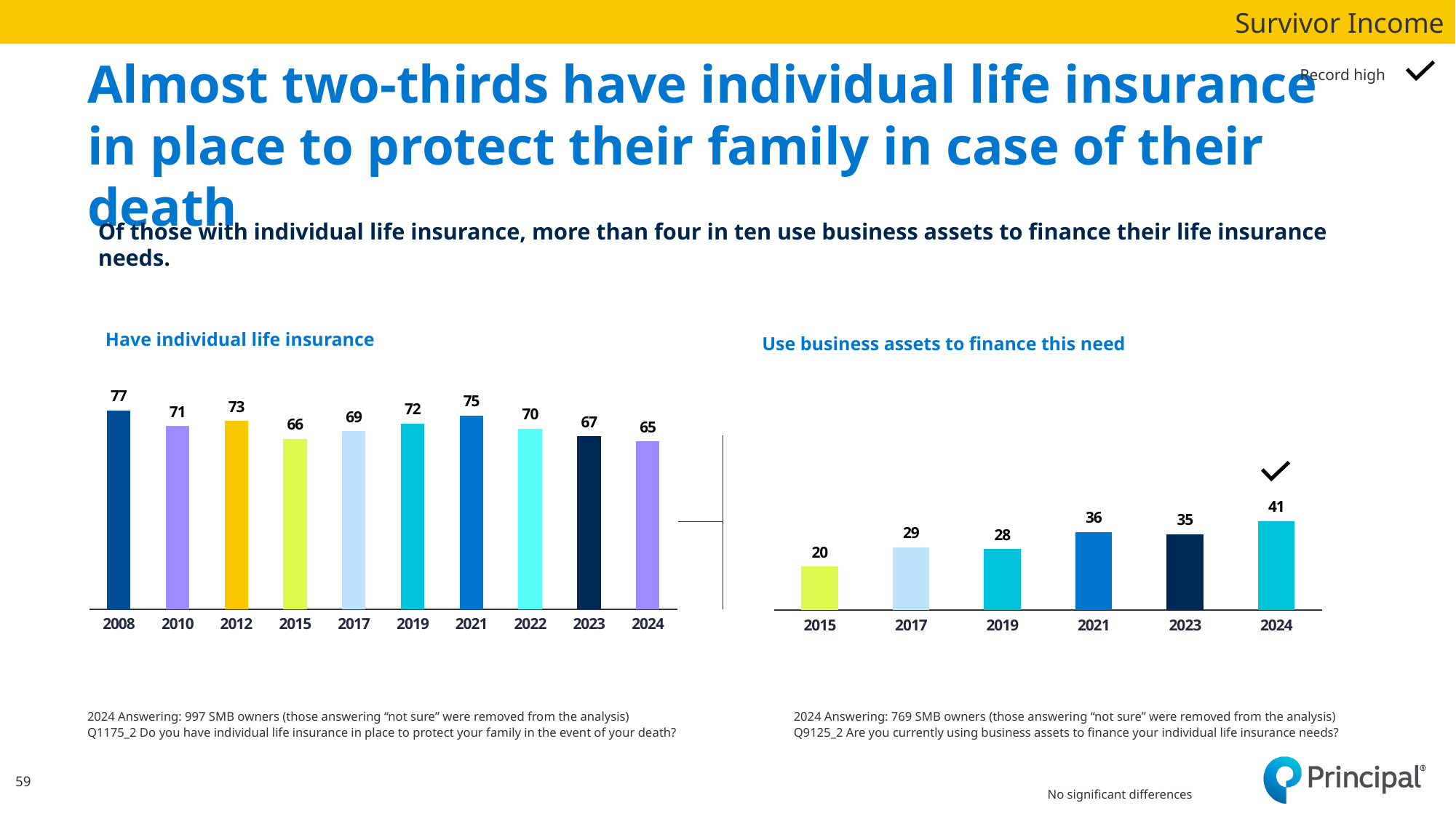
In the 'Have individual life insurance' chart, what is the difference between the 2021 value and the 2024 value? 10 In the 'Use business assets to finance this need' chart, what is the difference between the 2024 value and the 2015 value? 21 In the 'Use business assets to finance this need' chart, which is larger, the value for 2021 or the value for 2023? 2021 In the 'Have individual life insurance' chart, how many years are shown? 10 What kind of chart is the 'Use business assets to finance this need' chart? Bar chart In the 'Use business assets to finance this need' chart, what is the value for 2015? 20 In the 'Have individual life insurance' chart, which year has the lowest value? 2024 In the 'Have individual life insurance' chart, what is the value for 2024? 65 In the 'Use business assets to finance this need' chart, what is the value for 2024? 41 In the 'Have individual life insurance' chart, which year has the highest value? 2008 In the 'Use business assets to finance this need' chart, which year has the highest value? 2024 In the 'Have individual life insurance' chart, what is the value for 2008? 77